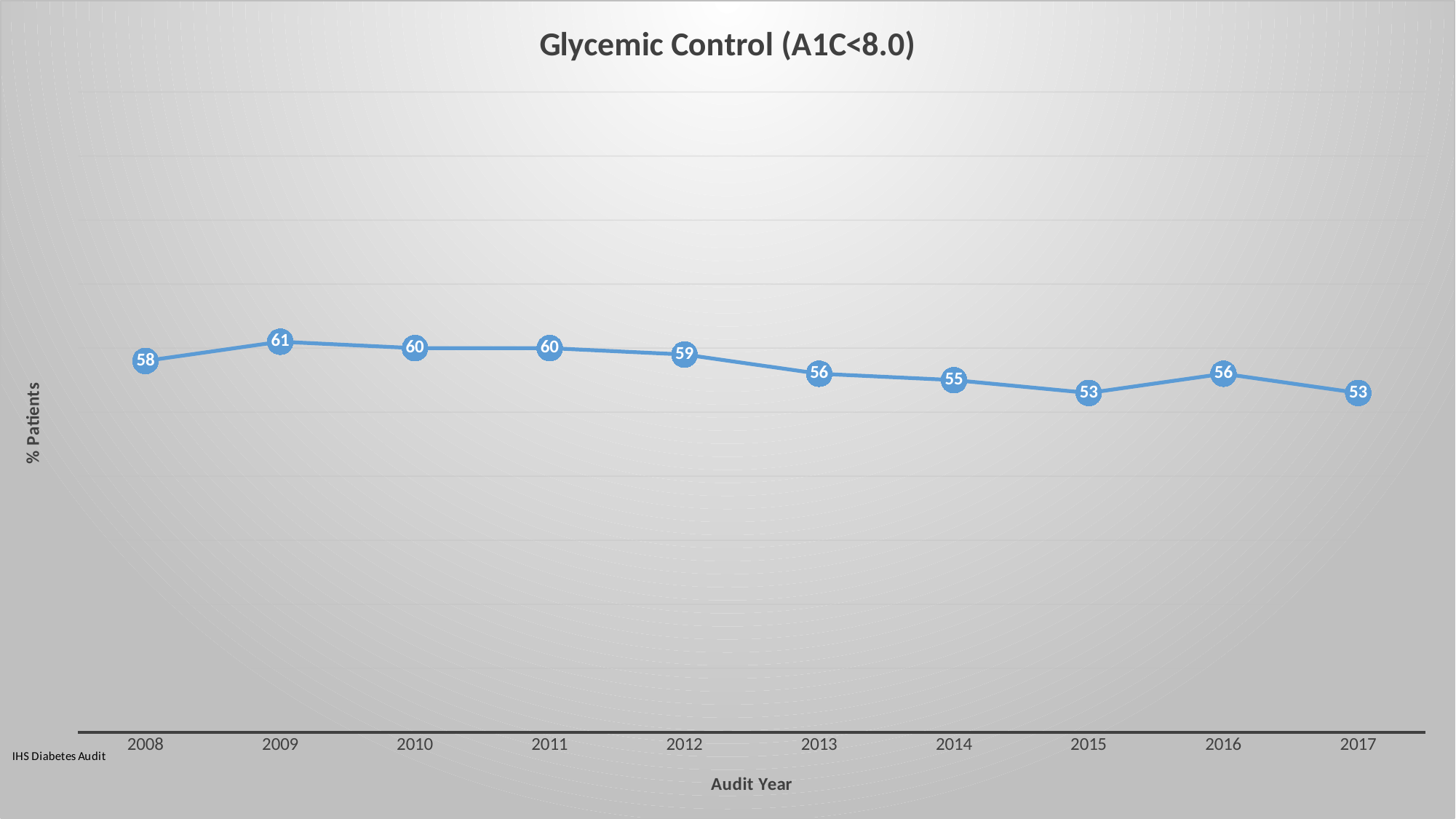
Which year has the highest value? 2009 What is the value for 2017? 53 Which is larger, the value for 2010 or the value for 2015? 2010 What is the difference between the values for 2012 and 2014? 4 What is the difference between the values for 2009 and 2017? 8 What is the title of the chart? Glycemic Control (A1C<8.0) What is the value for 2013? 56 What is the value for 2008? 58 Do the values generally rise or fall from 2009 to 2017? fall How many years are plotted on the x axis? 10 What kind of chart is shown? line chart What is the label of the y axis? % Patients